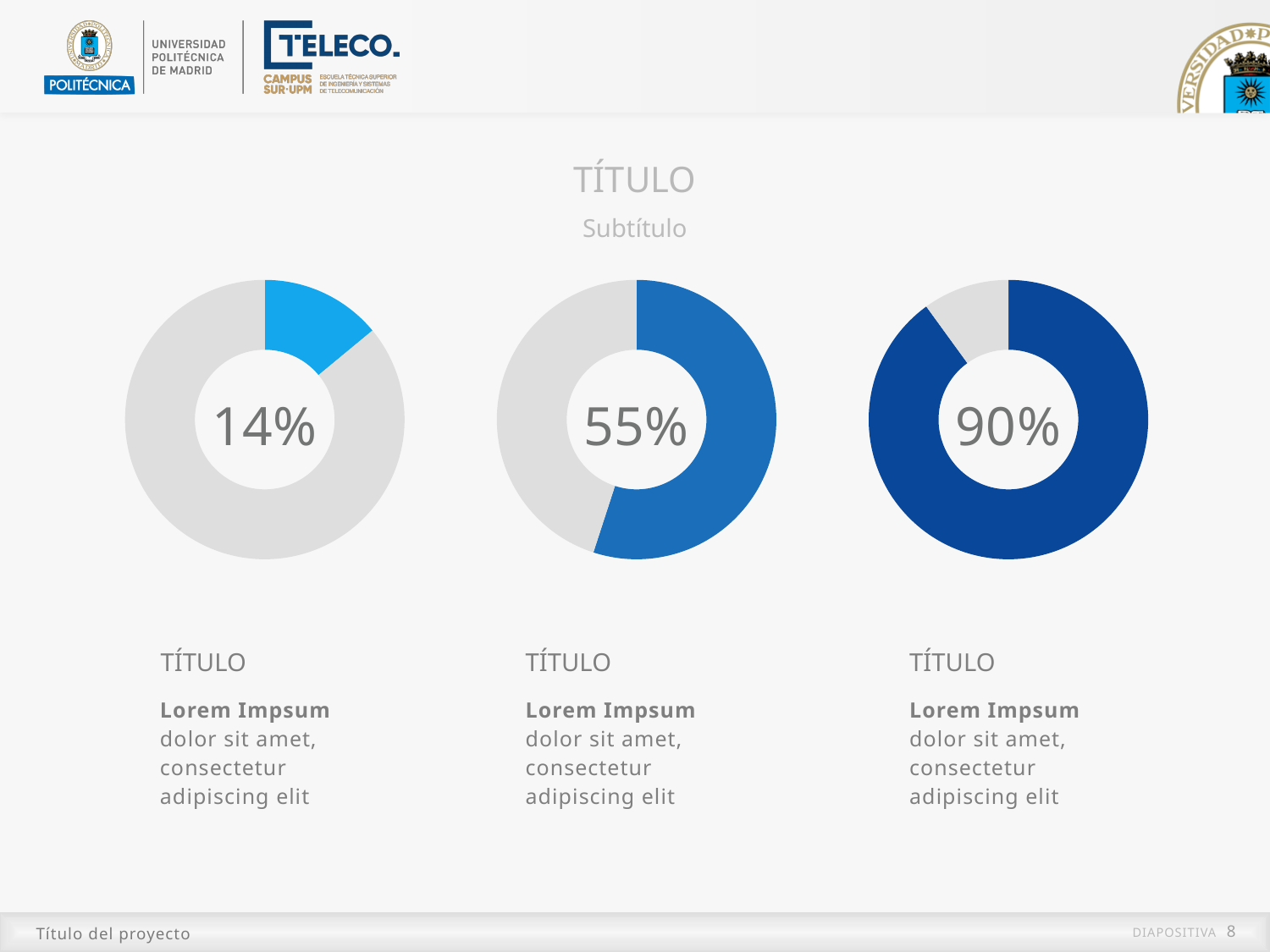
Which shows a larger percentage, the left donut chart or the middle donut chart? The middle chart Which of the three donut charts shows the highest percentage? The right chart (90%) Which of the three donut charts shows the lowest percentage? The left chart (14%) How many donut charts are shown on the slide? 3 Is the filled portion of the middle donut chart greater or less than 50%? greater What percentage is shown in the centre of the left donut chart? 14% What is the difference between the percentage in the right donut chart and the percentage in the left donut chart? 76% What is the difference between the percentage in the right donut chart and the percentage in the middle donut chart? 35% What percentage is shown in the centre of the middle donut chart? 55% What kind of chart is used for the three figures on the slide? Donut chart What is the difference between the percentage in the middle donut chart and the percentage in the left donut chart? 41% What percentage is shown in the centre of the right donut chart? 90%